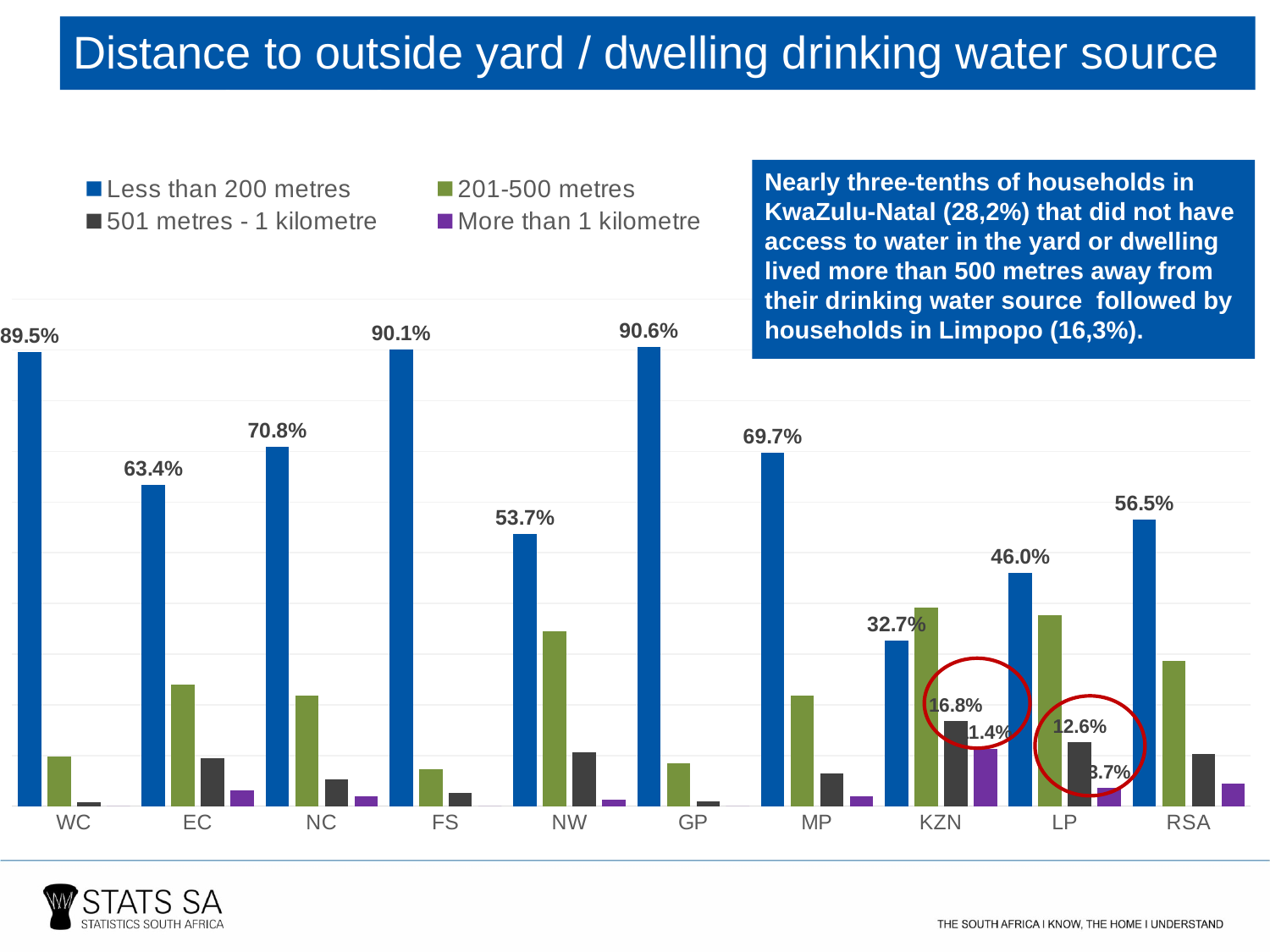
How many categories are shown on the x axis? 10 What is the value for 'Less than 200 metres' in KZN? 32.7% What is the difference between the 'Less than 200 metres' values for NC and EC? 7.4% What kind of chart is shown on the slide? Bar chart Which province has the highest value for 'Less than 200 metres'? GP How many series does the legend list? 4 What is the value for 'Less than 200 metres' in WC? 89.5% Which is larger, the 'Less than 200 metres' value for MP or for NW? MP Which category has the lowest value for 'Less than 200 metres'? KZN What is the title of the slide? Distance to outside yard / dwelling drinking water source What is the value for '501 metres - 1 kilometre' in LP? 12.6% What is the value for '501 metres - 1 kilometre' in KZN? 16.8%